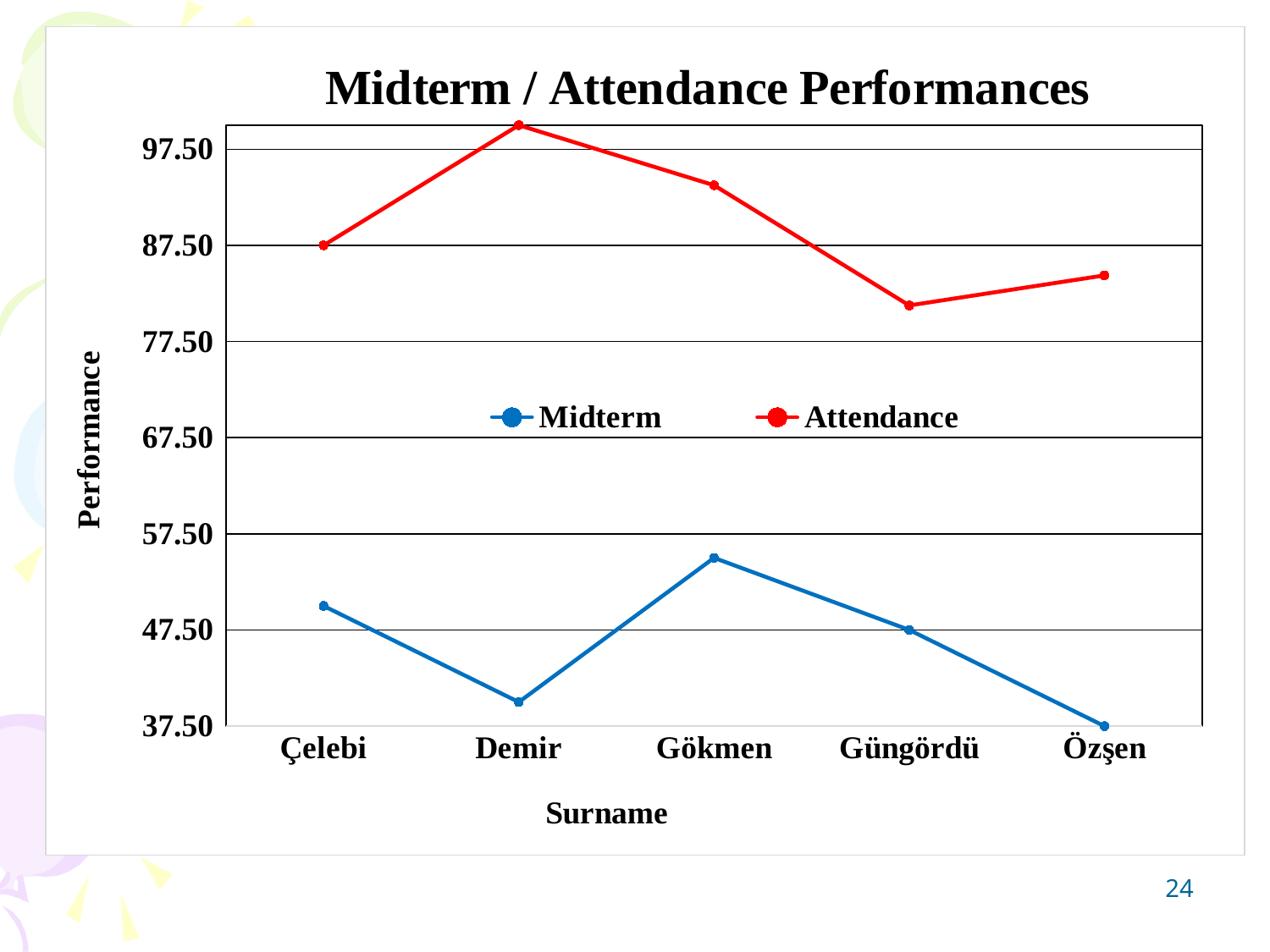
What kind of chart is shown on the slide? line chart What is the Midterm value for Özşen? 37.50 Which surname has the lowest Attendance value? Güngördü What is the Attendance value for Çelebi? 87.50 What is the title of the chart? Midterm / Attendance Performances What is the Midterm value for Güngördü? 47.50 Is the Attendance value for Gökmen greater or less than 87.50? greater Is the Midterm value for Demir greater or less than 47.50? less Which surname has the highest Attendance value? Demir Which surname has the highest Midterm value? Gökmen How many series does the legend list? 2 How many surnames are shown on the x axis? 5